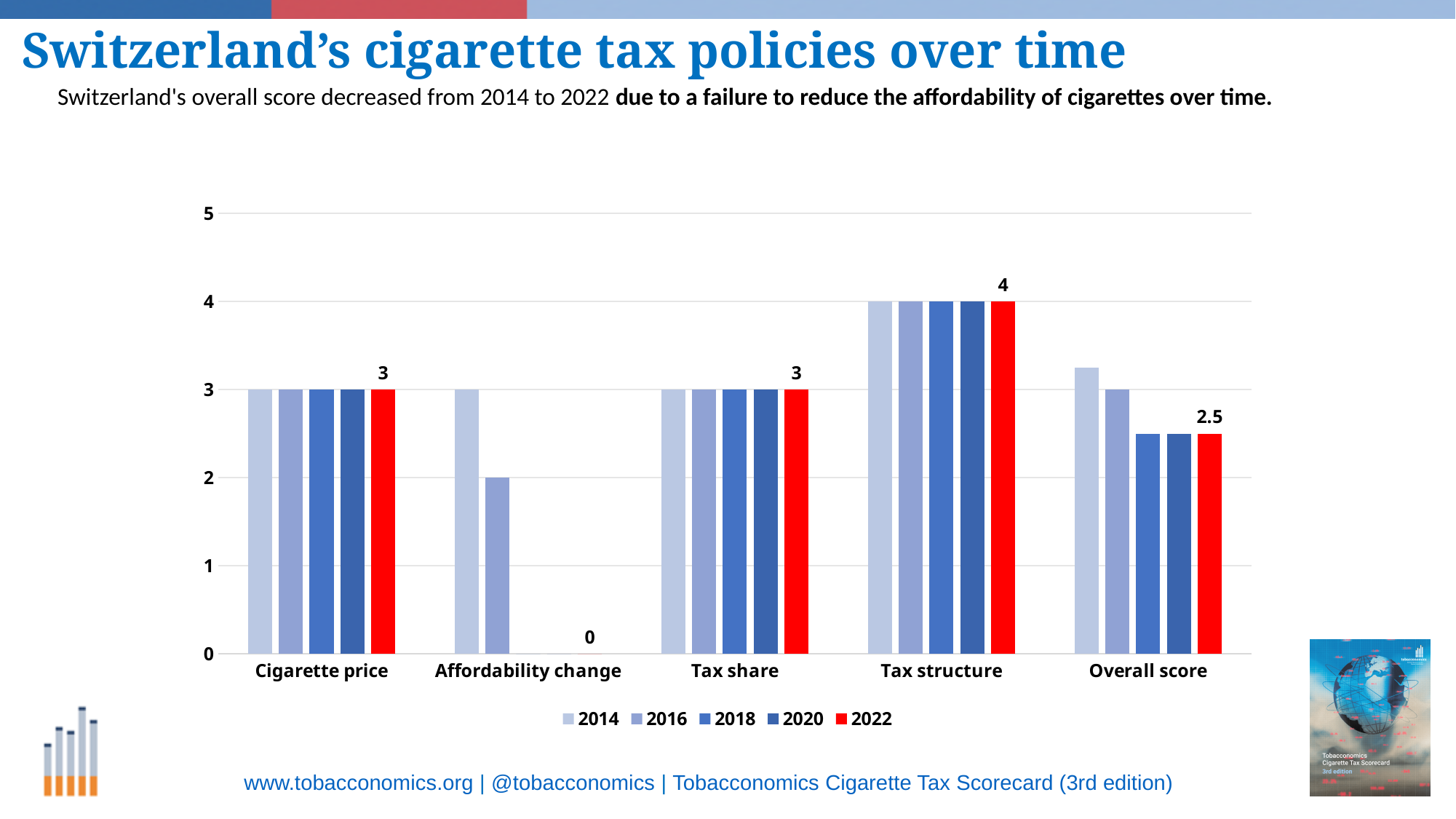
Do the Overall score values rise or fall from 2014 to 2022? fall Which category has the lowest 2022 value? Affordability change What kind of chart is shown on the slide? bar chart How many categories are shown on the x axis? 5 Which category has the highest 2022 value? Tax structure How many series does the legend list? 5 Which is larger in 2022: Cigarette price or Overall score? Cigarette price What is the difference between the 2022 values for Tax structure and Overall score? 1.5 Is the 2014 value for Overall score greater or less than 3? greater What is the 2022 value for Affordability change? 0 What is the 2022 value for Overall score? 2.5 What is the 2022 value for Tax structure? 4